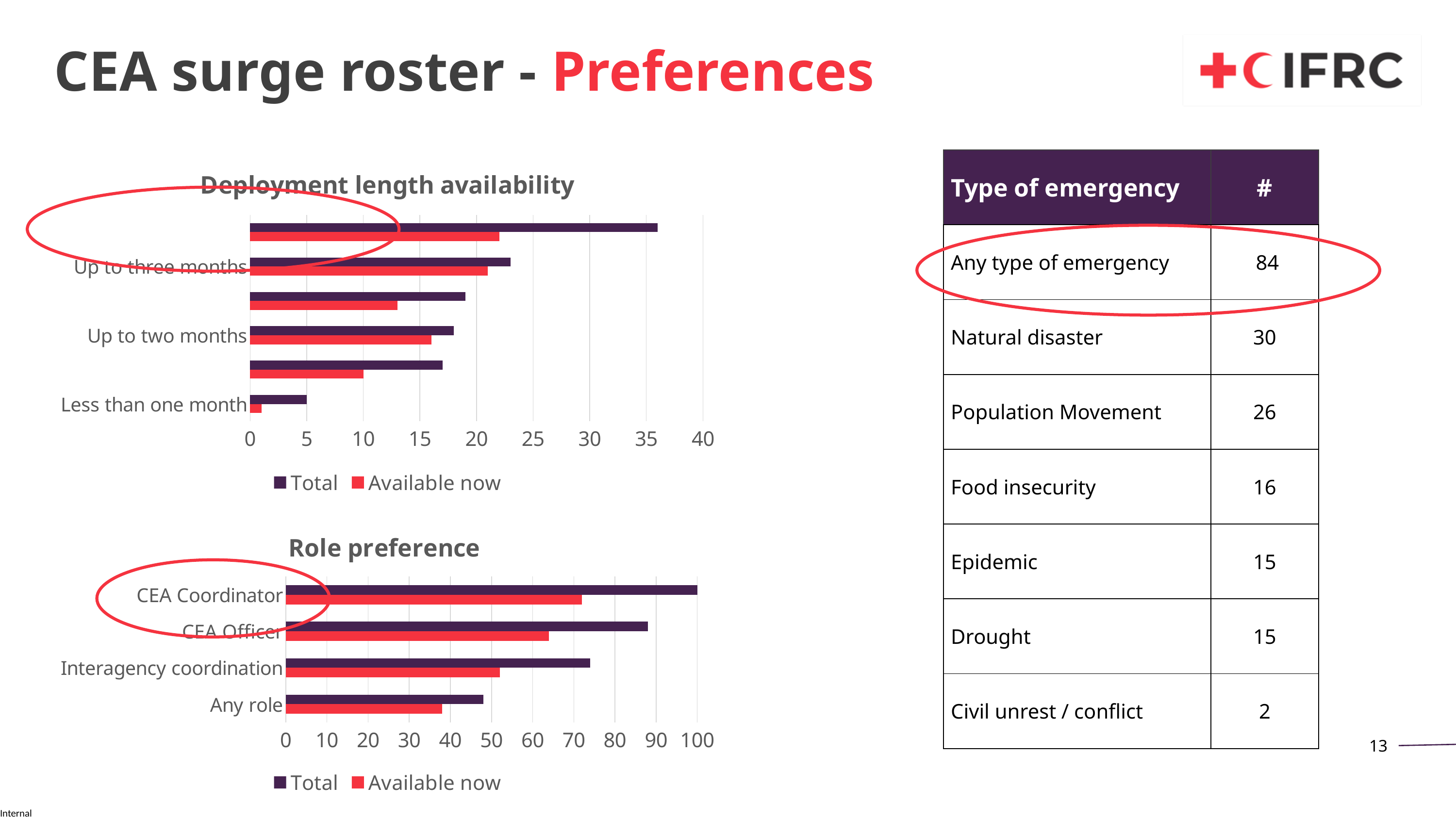
In the Role preference chart, which role has the lowest Total value? Any role In the Role preference chart, which role has the highest Total value? CEA Coordinator In the Deployment length availability chart, which labelled category has the lowest Total value? Less than one month What are the two legend entries of the Deployment length availability chart? Total and Available now How many roles are shown in the Role preference chart? 4 In the Deployment length availability chart, is the Total value for Up to two months greater or less than 15? greater In the Role preference chart, is the Total value for CEA Coordinator greater or less than 90? greater What kind of chart is the Role preference chart? bar chart In the Deployment length availability chart, is the Total value for Less than one month greater or less than 10? less In the Role preference chart, which has the larger Total value: CEA Officer or Interagency coordination? CEA Officer How many series does the legend of the Role preference chart list? 2